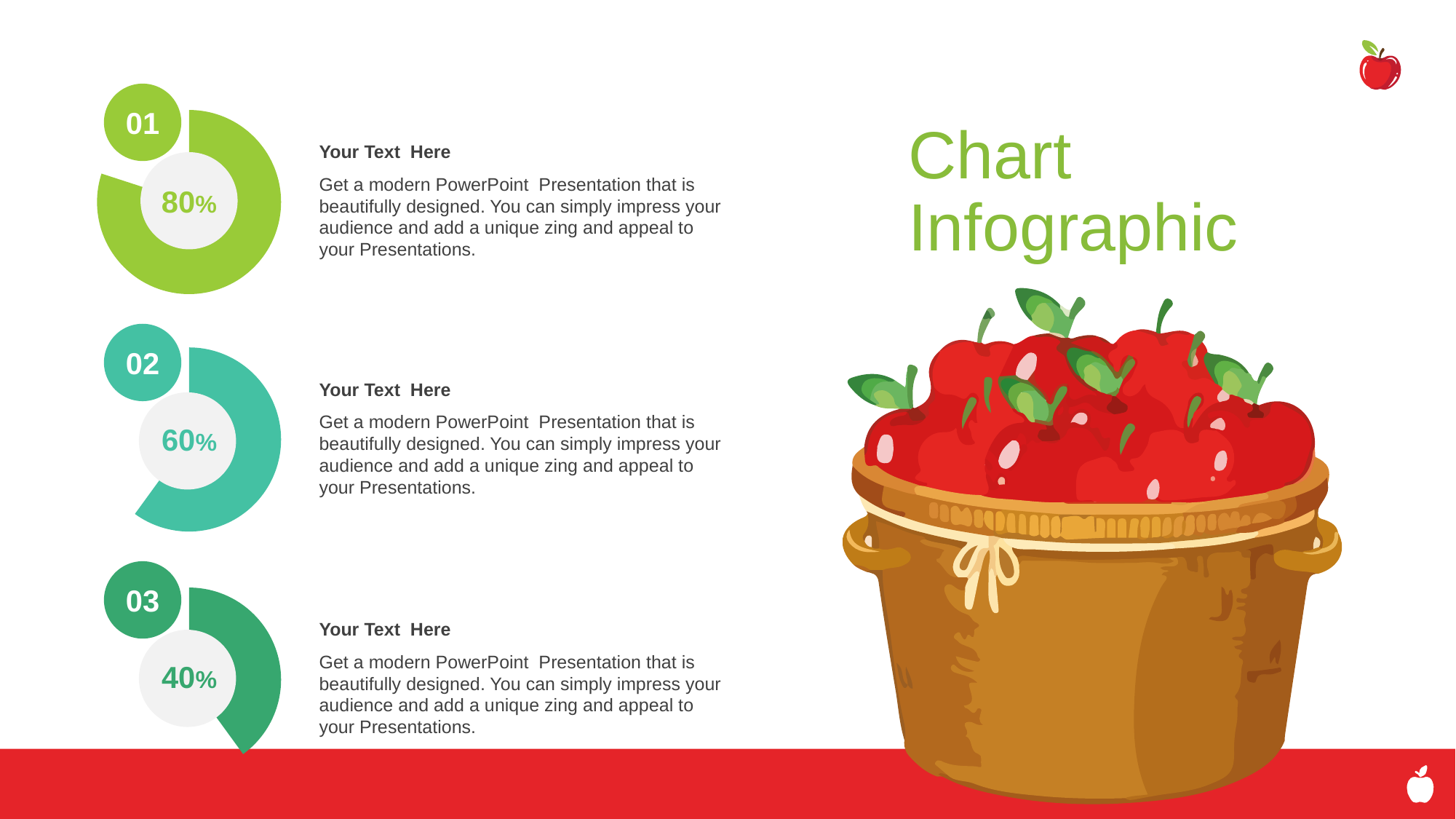
What is the title text shown on the right side of the slide? Chart Infographic What kind of chart is used for the three numbered items on the left of the slide? Donut (ring) chart What is the difference between the percentage in chart 01 and the percentage in chart 03? 40% Which of the three numbered ring charts shows the highest percentage? 01 What percentage is shown in the ring chart labelled 03? 40% Which shows a larger percentage, chart 01 or chart 02? Chart 01 What percentage is shown in the ring chart labelled 02? 60% Which of the three numbered ring charts shows the lowest percentage? 03 How many ring charts are shown on the slide? 3 What is the difference between the percentage in chart 02 and the percentage in chart 03? 20% Do the percentages rise or fall going from chart 01 down to chart 03? Fall What percentage is shown in the ring chart labelled 01? 80%